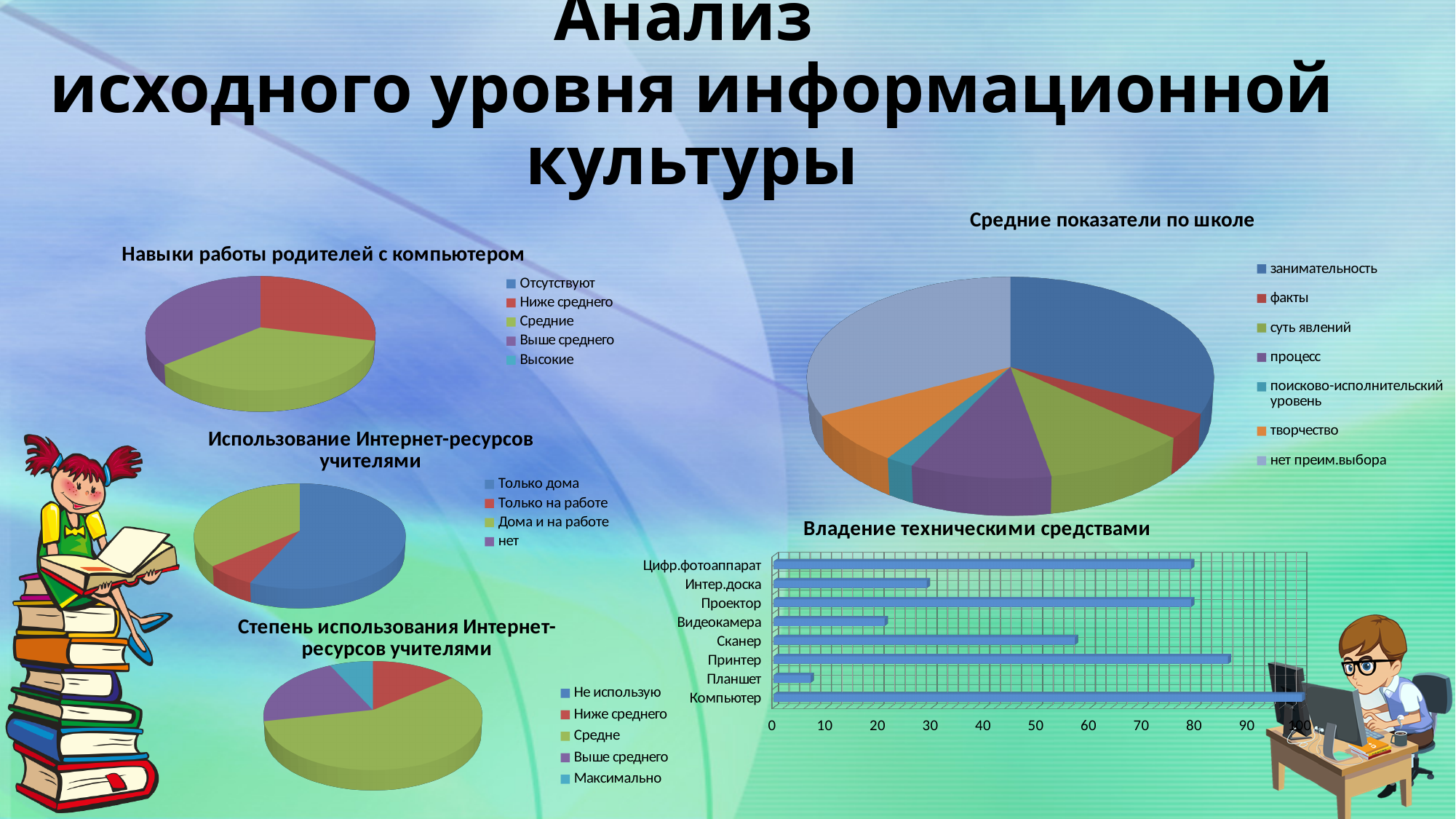
In the chart 'Владение техническими средствами', is the value for Видеокамера greater or less than 30? less In the chart 'Владение техническими средствами', which category has the lowest value? Планшет In the pie chart 'Использование Интернет-ресурсов учителями', which category has the largest slice? Только дома In the pie chart 'Средние показатели по школе', which category has the smallest slice? поисково-исполнительский уровень In the chart 'Владение техническими средствами', how many categories are shown? 8 How many entries does the legend of the chart 'Средние показатели по школе' list? 7 In the chart 'Владение техническими средствами', is the value for Сканер greater or less than 50? greater What kind of chart is 'Владение техническими средствами'? bar chart In the chart 'Владение техническими средствами', which is larger: Принтер or Сканер? Принтер In the chart 'Владение техническими средствами', which category has the highest value? Компьютер In the chart 'Владение техническими средствами', is the value for Планшет greater or less than 10? less